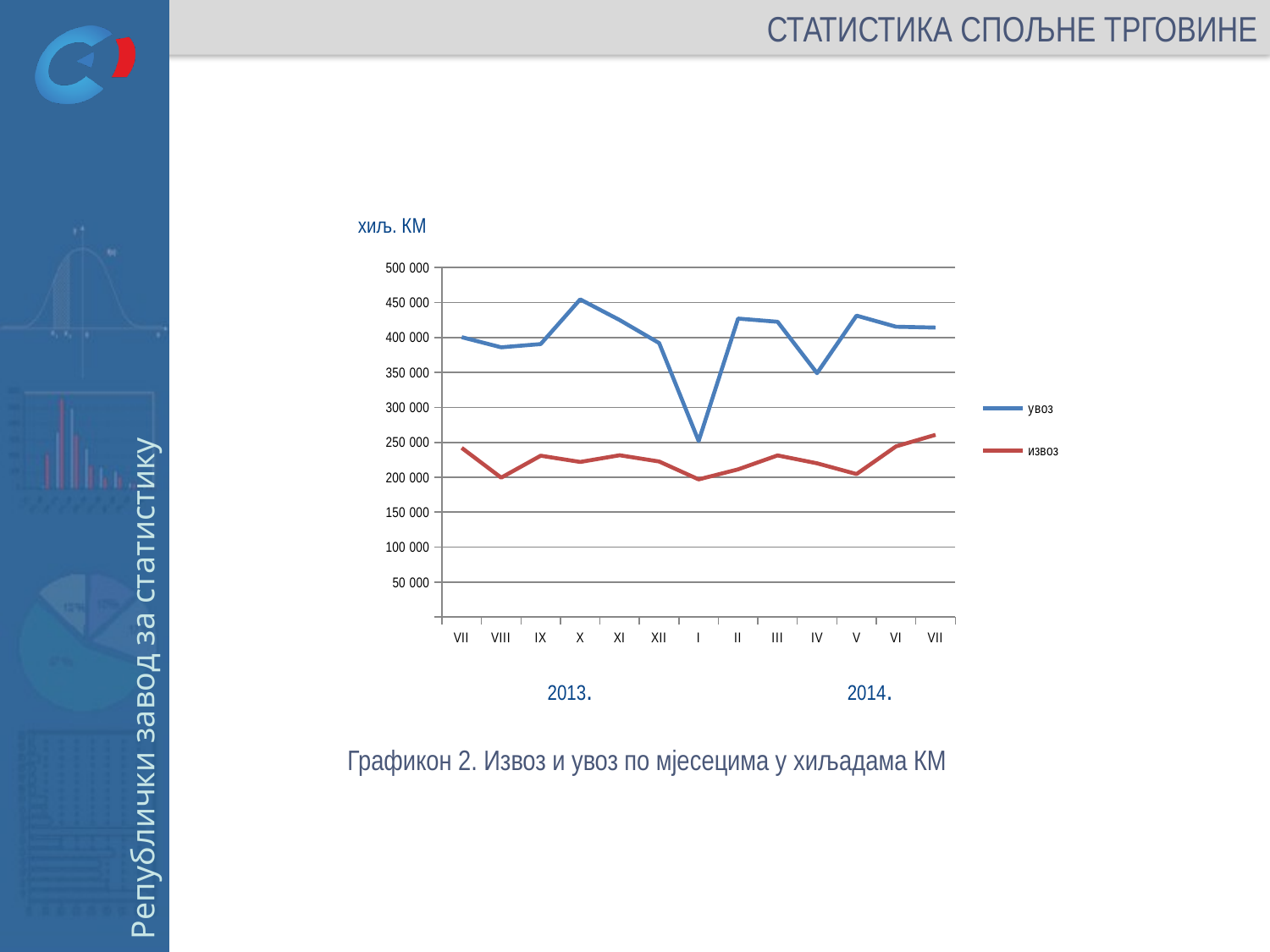
In which month does the увоз series reach its highest value? X (2013) Which series is higher in month IV of 2014, увоз or извоз? увоз How many series does the legend list? 2 Is the value of увоз in month I of 2014 greater or less than 300 000? less Is the value of извоз in month VIII of 2013 greater or less than 250 000? less How many months are plotted along the x axis? 13 In which month does the извоз series reach its highest value? VII (2014) Is the value of увоз in month X of 2013 greater or less than 400 000? greater In which month does the увоз series reach its lowest value? I (2014) Does the извоз series rise or fall from month V of 2014 to month VII of 2014? rise What kind of chart is shown on the slide? line chart What unit is stated above the chart's y axis? хиљ. КМ